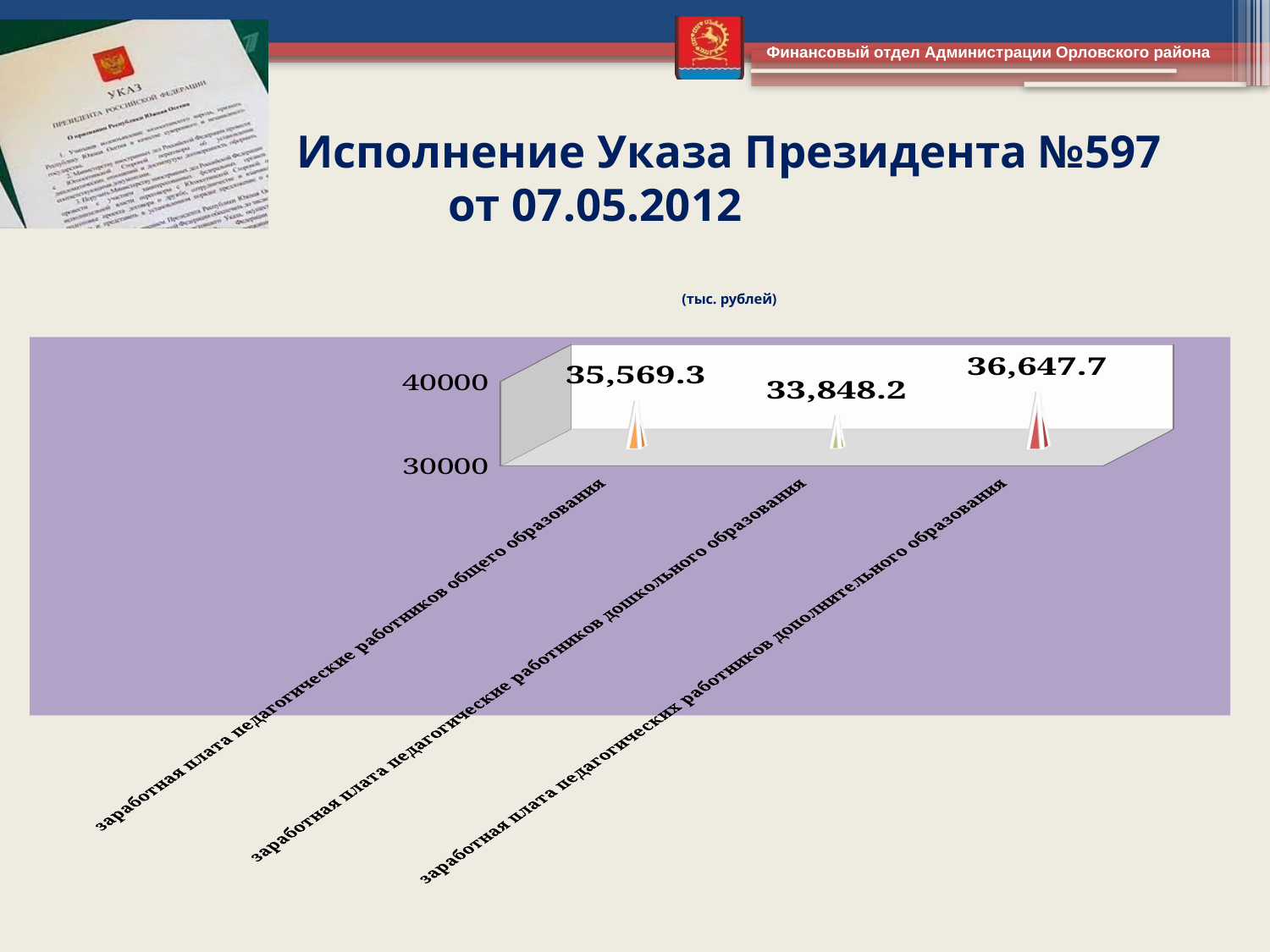
Which category has the lowest value? заработная плата педагогических работников дошкольного образования What is the difference between the value for дополнительного образования and the value for общего образования? 1,078.4 What is the value for заработная плата педагогических работников дополнительного образования? 36,647.7 What unit is indicated above the chart? тыс. рублей What is the value for заработная плата педагогических работников общего образования? 35,569.3 What is the value for заработная плата педагогических работников дошкольного образования? 33,848.2 How many categories are shown in the chart? 3 Is the value for дошкольного образования greater or less than 30000? greater Which category has the highest value? заработная плата педагогических работников дополнительного образования Which is larger: the value for общего образования or the value for дошкольного образования? общего образования What kind of chart is shown on the slide? bar chart What is the difference between the value for общего образования and the value for дошкольного образования? 1,721.1